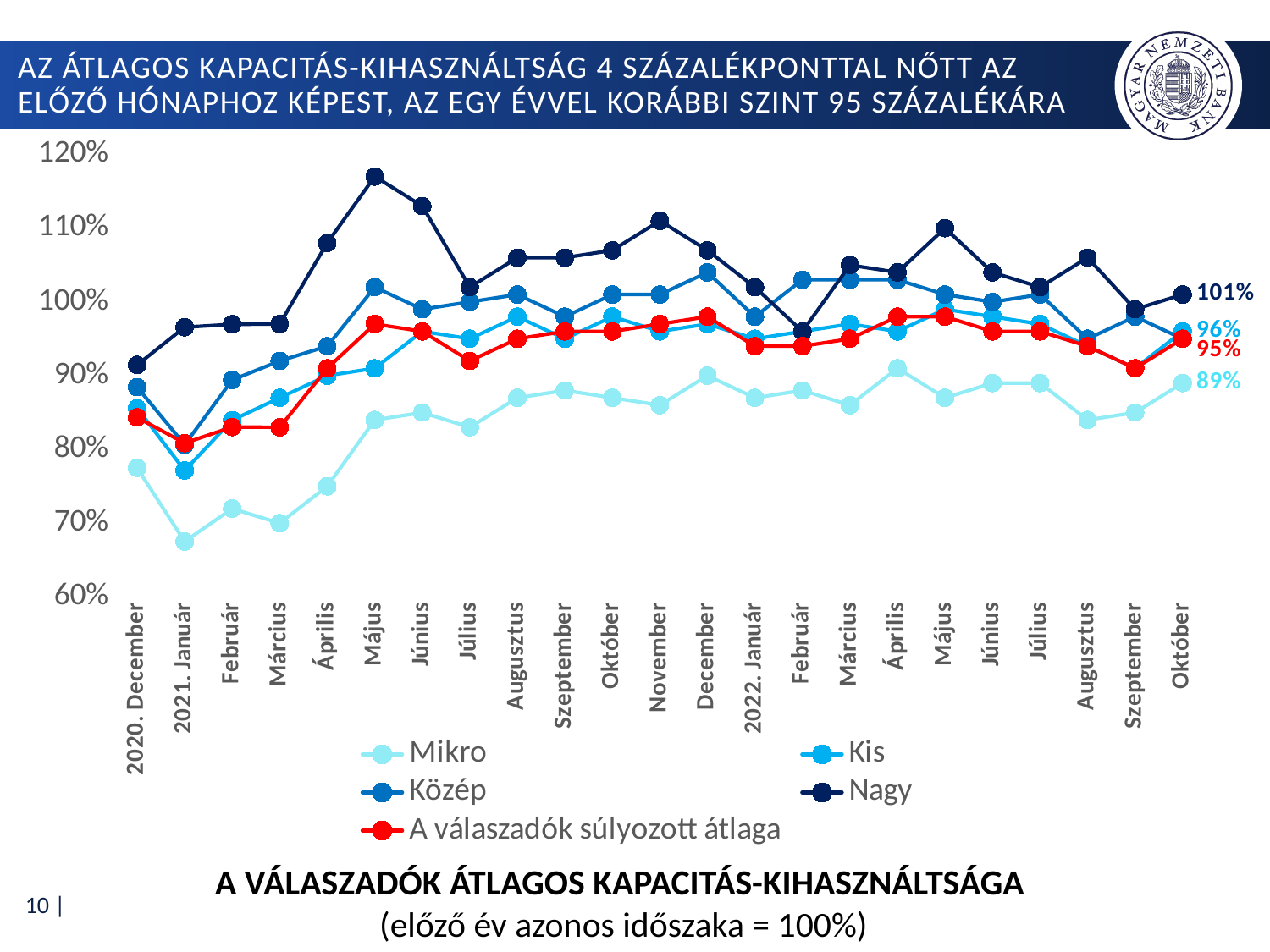
Which series has the lowest value in 2021 Január? Mikro What is the value of the Kis series in 2022 Október? 96% How many months are shown on the x axis? 23 What is the value of the Nagy series in 2022 Október? 101% What kind of chart is shown on the slide? Line chart What is the value of the Mikro series in 2022 Október? 89% Which series has the highest value in 2021 Május? Nagy Is the value for Mikro in 2021 Január greater or less than 70%? less What is the value of 'A válaszadók súlyozott átlaga' in 2022 Október? 95% Is the value for Nagy in 2021 Május greater or less than 110%? greater What is the difference between the Nagy and Mikro values in 2022 Október? 12 percentage points How many series does the legend list? 5